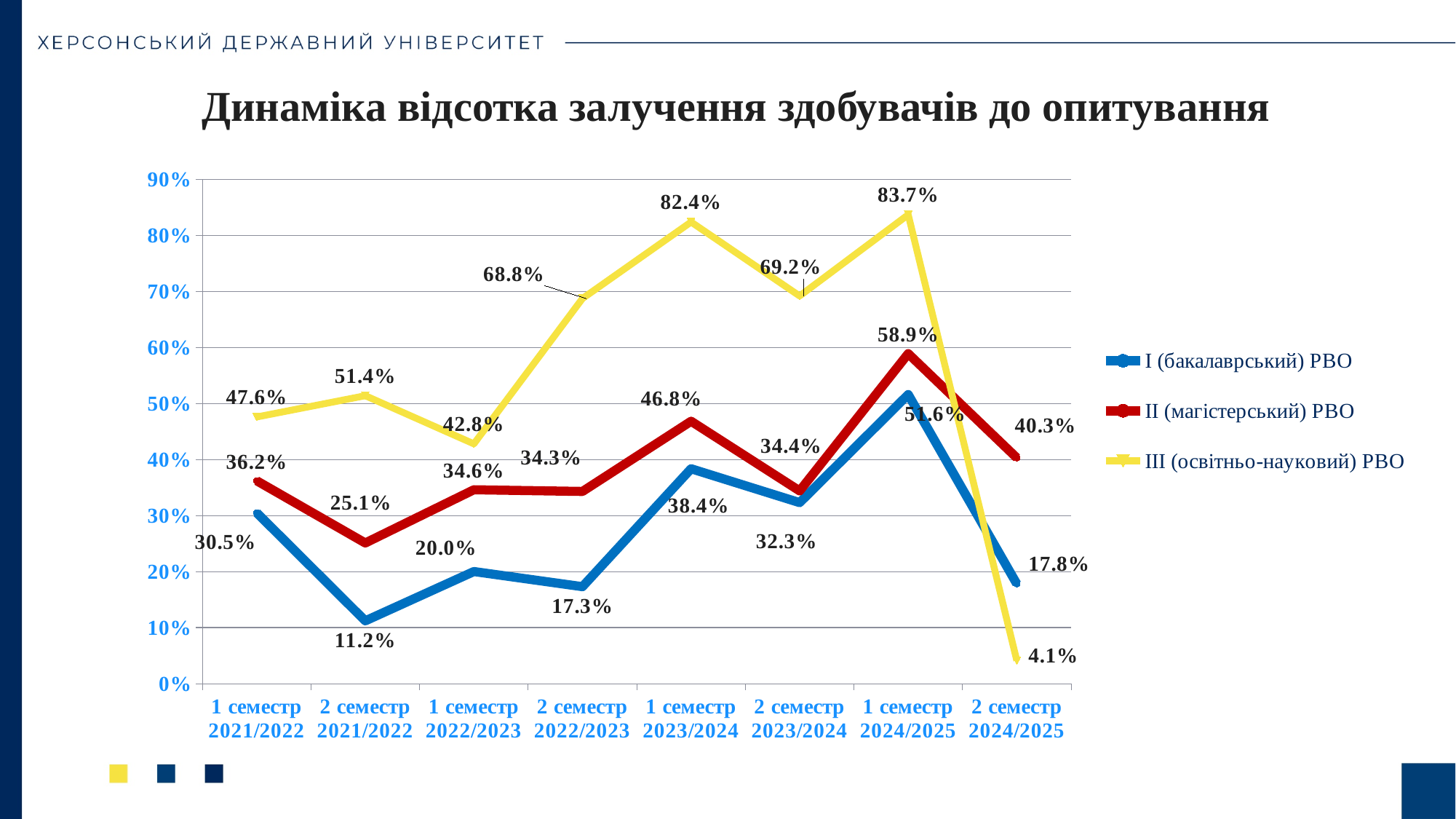
How many series does the legend list? 3 What is the value for I (бакалаврський) РВО in 2 семестр 2021/2022? 11.2% What is the title of the chart? Динаміка відсотка залучення здобувачів до опитування In which semester does III (освітньо-науковий) РВО have its lowest value? 2 семестр 2024/2025 What kind of chart is shown on the slide? line chart What is the value for II (магістерський) РВО in 2 семестр 2024/2025? 40.3% Which series has the larger value in 2 семестр 2024/2025: I (бакалаврський) РВО or III (освітньо-науковий) РВО? I (бакалаврський) РВО Does the value for I (бакалаврський) РВО rise or fall from 1 семестр 2024/2025 to 2 семестр 2024/2025? fall How many semesters are plotted along the x axis? 8 What is the difference between the III (освітньо-науковий) РВО values in 1 семестр 2024/2025 and 2 семестр 2024/2025? 79.6% In which semester does II (магістерський) РВО reach its highest value? 1 семестр 2024/2025 What is the value for III (освітньо-науковий) РВО in 1 семестр 2024/2025? 83.7%